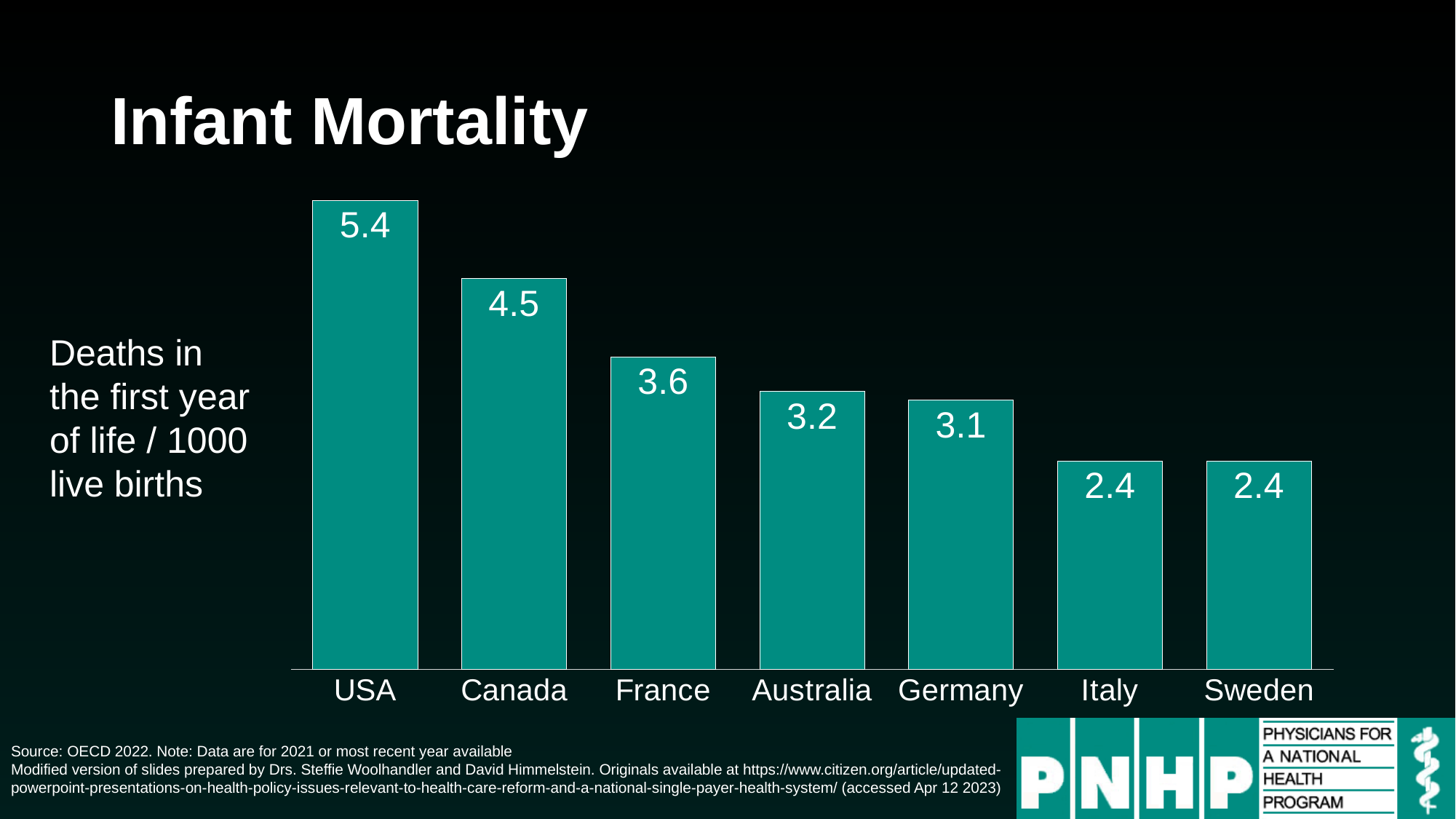
Which has a higher infant mortality value, Australia or Germany? Australia What kind of chart is shown on the slide? Bar chart Do the values rise or fall moving from left to right across the chart? Fall What is the title of the chart on the slide? Infant Mortality What is the infant mortality value shown for France? 3.6 What is the difference between the infant mortality values for the USA and Canada? 0.9 How many countries are shown on the chart? 7 Which country has the highest infant mortality on the chart? USA What is the infant mortality value shown for the USA? 5.4 What is the difference between the infant mortality values for France and Sweden? 1.2 What is the infant mortality value shown for Germany? 3.1 Which countries share the lowest infant mortality value on the chart? Italy and Sweden